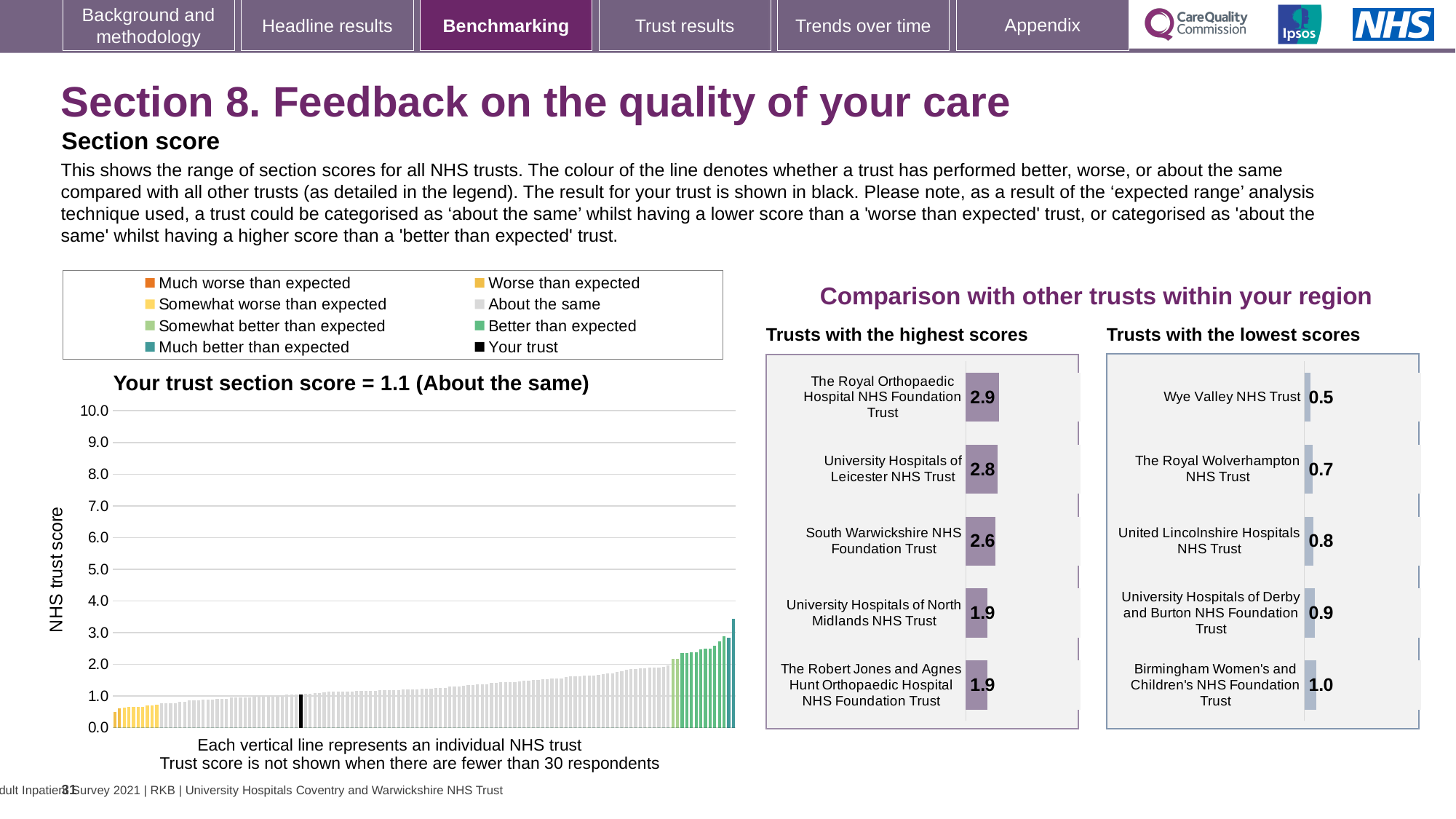
In the 'Your trust section score' chart, do the bars rise or fall from left to right along the x axis? rise According to the title of the 'Your trust section score' chart, what is your trust's section score? 1.1 In the 'Trusts with the lowest scores' chart, which has the larger score: The Royal Wolverhampton NHS Trust or Birmingham Women's and Children's NHS Foundation Trust? Birmingham Women's and Children's NHS Foundation Trust How many entries does the legend above the 'Your trust section score' chart list? 8 In the 'Trusts with the lowest scores' chart, what is the score for Wye Valley NHS Trust? 0.5 In the 'Trusts with the highest scores' chart, what is the difference between the scores of The Royal Orthopaedic Hospital NHS Foundation Trust and University Hospitals of North Midlands NHS Trust? 1.0 In the 'Trusts with the highest scores' chart, which trust has the highest score? The Royal Orthopaedic Hospital NHS Foundation Trust How many trusts are shown in the 'Trusts with the lowest scores' chart? 5 In the 'Trusts with the lowest scores' chart, which trust has the lowest score? Wye Valley NHS Trust In the 'Your trust section score' chart, is the value of the tallest bar greater or less than 3.0? greater In the 'Trusts with the highest scores' chart, what is the score for South Warwickshire NHS Foundation Trust? 2.6 In the 'Trusts with the highest scores' chart, what is the score for The Royal Orthopaedic Hospital NHS Foundation Trust? 2.9